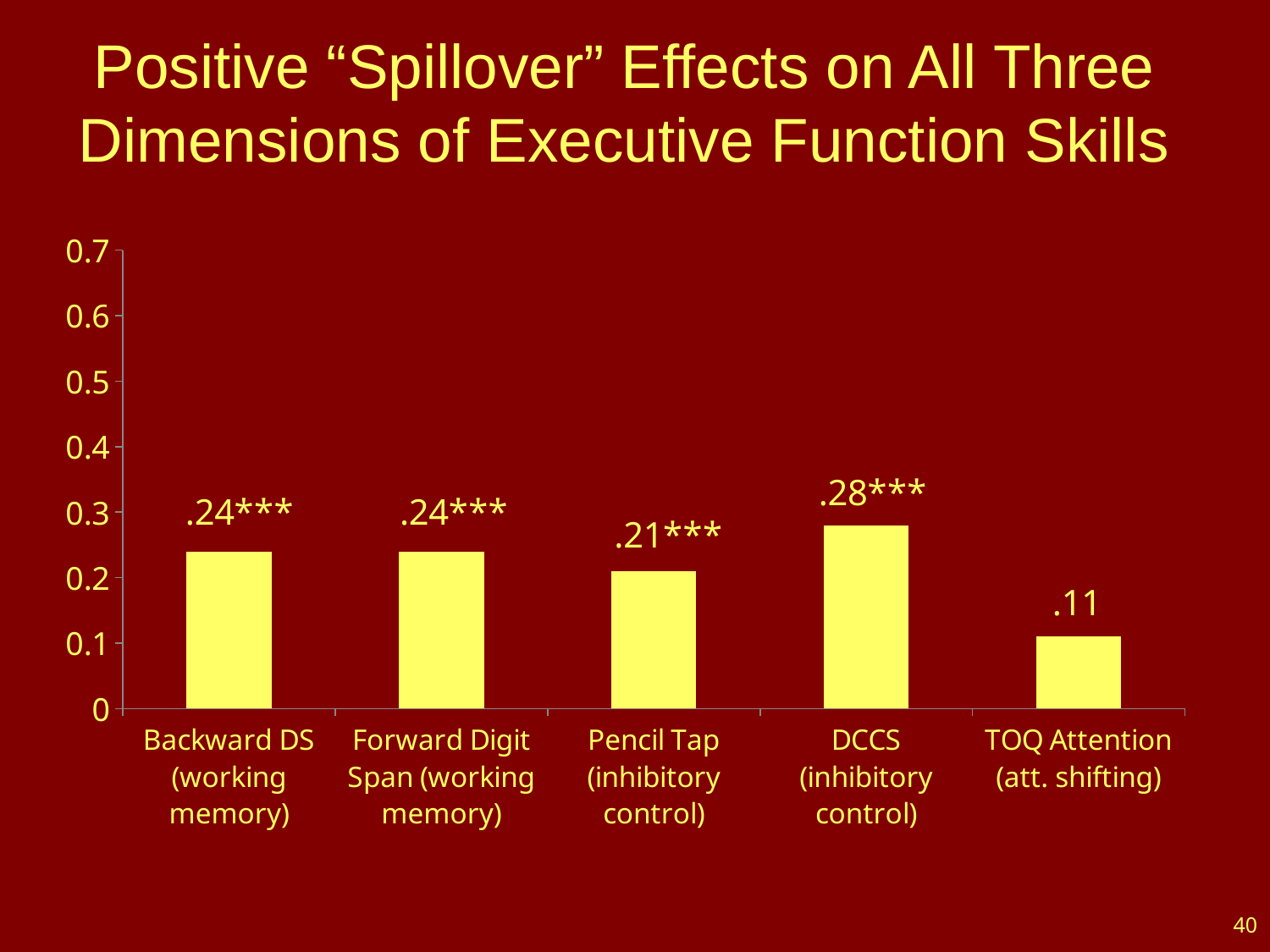
What is the highest value labelled on the y axis? 0.7 What is the difference between the values for DCCS and TOQ Attention? .17 What is the title of the slide? Positive "Spillover" Effects on All Three Dimensions of Executive Function Skills What is the value shown for Pencil Tap (inhibitory control)? .21*** Which category has the lowest bar? TOQ Attention (att. shifting) Is the value for Backward DS (working memory) greater or less than 0.3? less What is the value shown for TOQ Attention (att. shifting)? .11 How many categories are shown on the x axis? 5 What kind of chart is shown on the slide? bar chart Which category has the highest bar? DCCS (inhibitory control) What is the value shown for DCCS (inhibitory control)? .28*** Which is larger, the value for Pencil Tap or the value for DCCS? DCCS